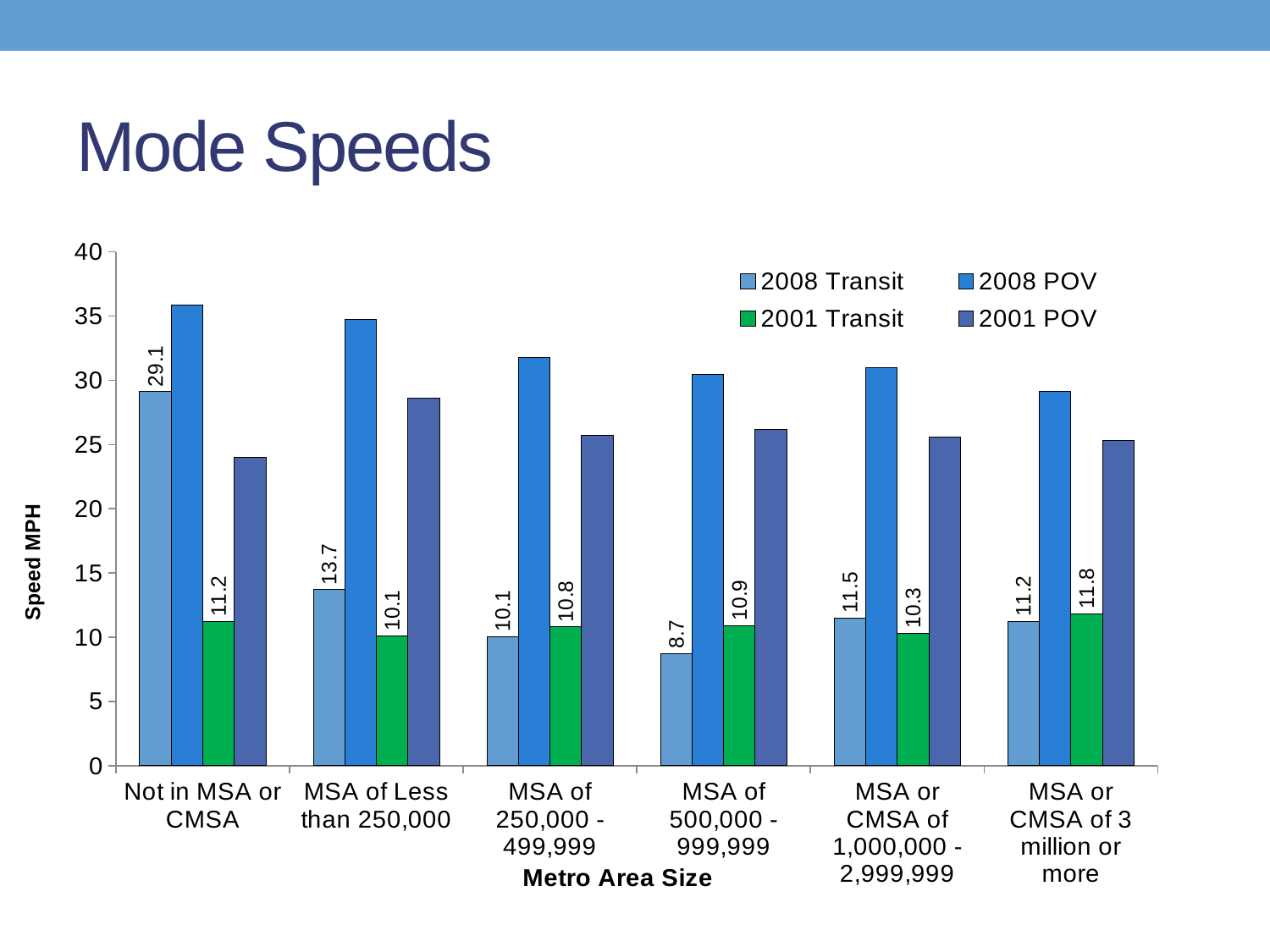
What is the 2001 Transit speed for 'MSA of 500,000 - 999,999'? 10.9 For 'MSA of Less than 250,000', which is larger: the 2008 Transit speed or the 2001 Transit speed? 2008 Transit What is the difference between the 2008 Transit and 2001 Transit speeds for 'Not in MSA or CMSA'? 17.9 Is the 2001 POV speed for 'Not in MSA or CMSA' greater or less than 25? less Which metro area size has the lowest 2008 Transit speed? MSA of 500,000 - 999,999 How many series does the legend list? 4 What is the 2008 Transit speed for 'MSA or CMSA of 3 million or more'? 11.2 Is the 2008 POV speed for 'Not in MSA or CMSA' greater or less than 35? greater How many metro area size categories are shown on the x axis? 6 What type of chart is shown on the slide? Bar chart Which metro area size has the highest 2008 Transit speed? Not in MSA or CMSA What is the 2008 Transit speed for the 'Not in MSA or CMSA' category? 29.1